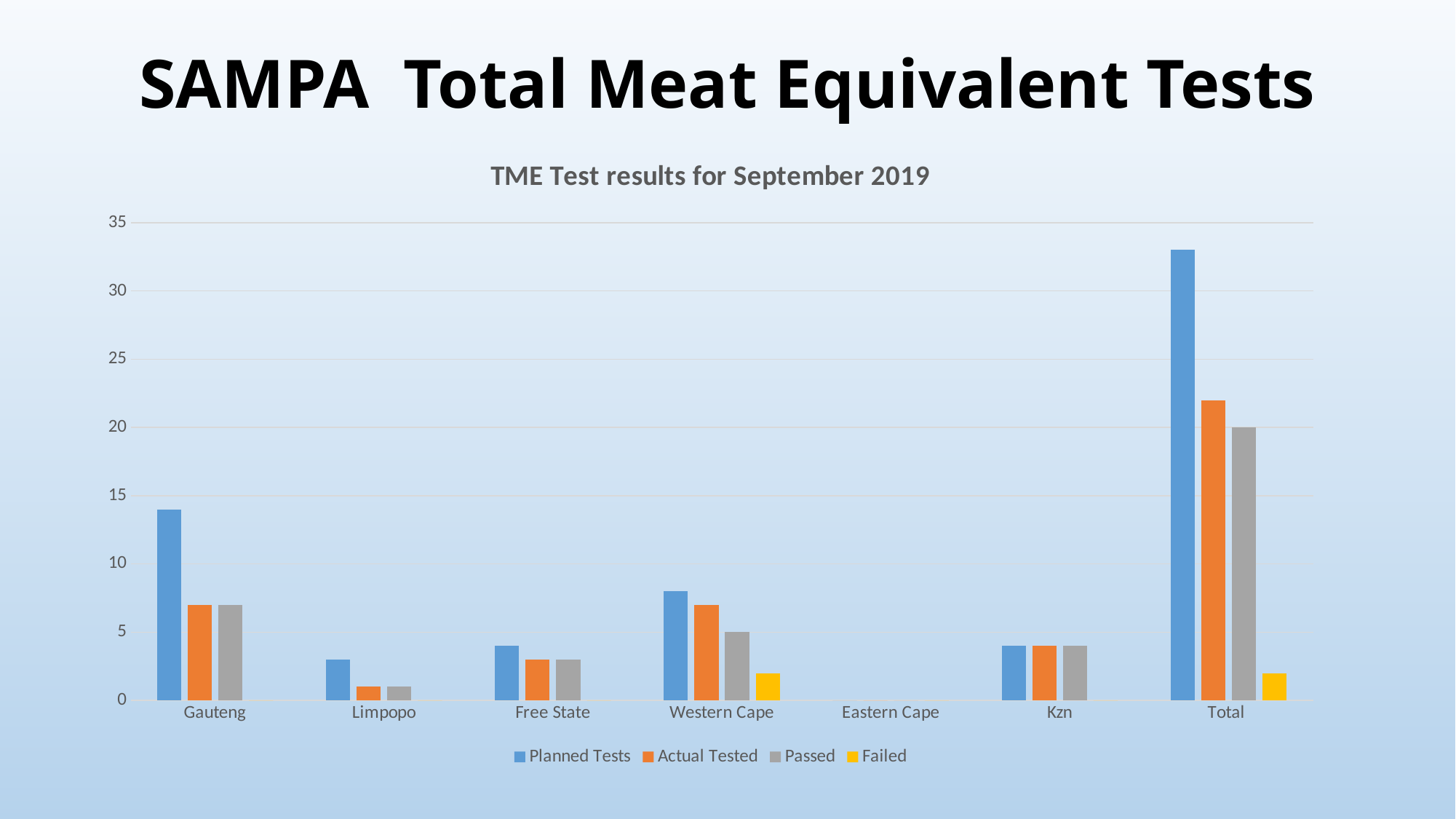
How many categories are shown on the x axis? 7 Which is larger, the Planned Tests value for Gauteng or for Western Cape? Gauteng Is the Planned Tests value for Total greater or less than 30? greater Which colour represents the Failed series in the legend? Yellow Which category has the highest Planned Tests value? Total Is the Actual Tested value for Limpopo greater or less than 5? less How many series does the legend list? 4 Is the Actual Tested value for Total greater or less than 20? greater What kind of chart is shown on the slide? Bar chart Which category shows no bars at all (all values at zero)? Eastern Cape What is the title of the chart? TME Test results for September 2019